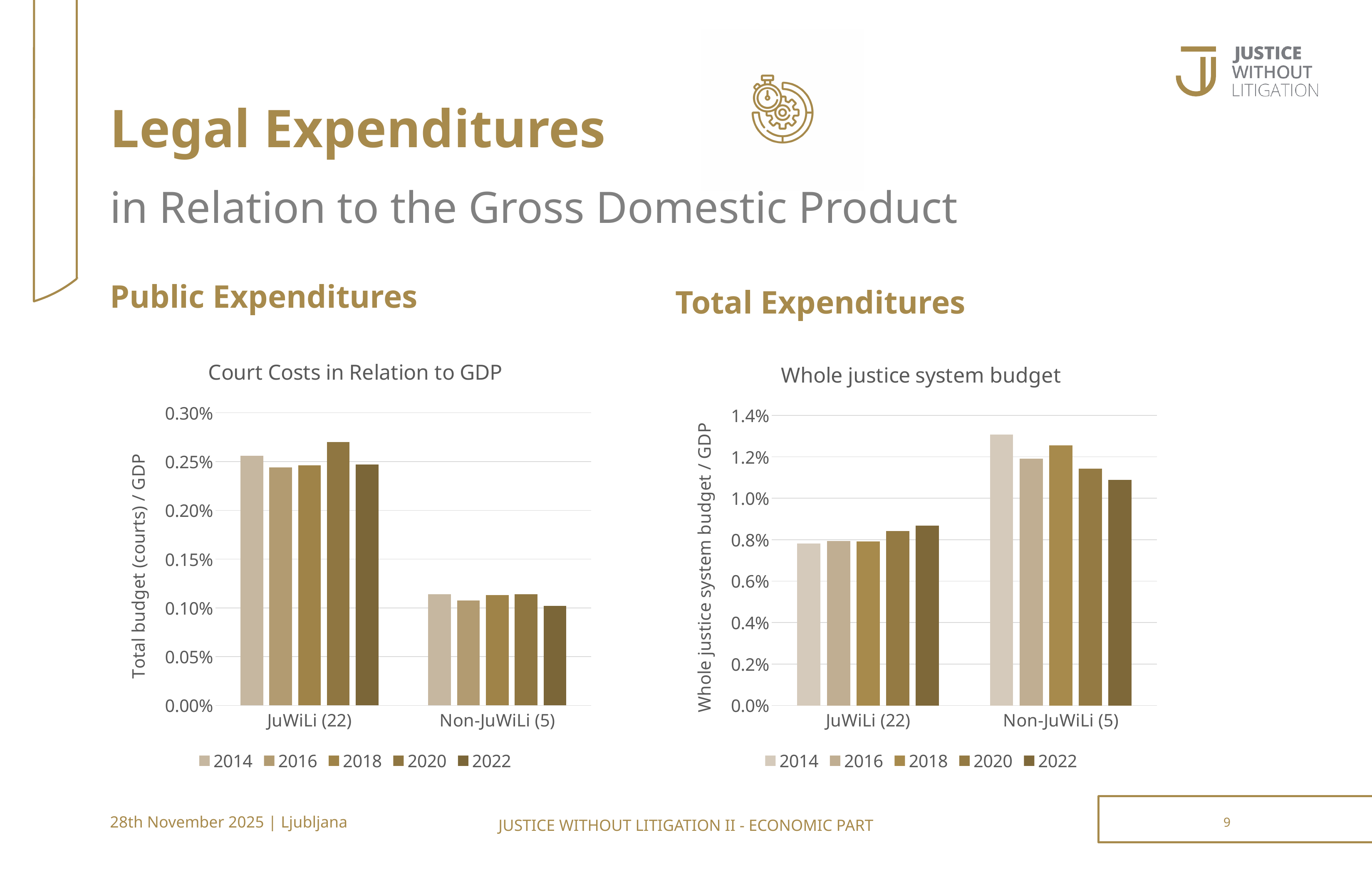
In the 'Court Costs in Relation to GDP' chart, what kind of chart is shown? bar chart In the 'Court Costs in Relation to GDP' chart, how many series does the legend list? 5 In the 'Whole justice system budget' chart, what is the label of the vertical axis? Whole justice system budget / GDP In the 'Whole justice system budget' chart, is the 2022 value for JuWiLi (22) greater or less than 1.0%? less In the 'Whole justice system budget' chart, which year has the highest value for Non-JuWiLi (5)? 2014 In the 'Court Costs in Relation to GDP' chart, which year has the highest value for JuWiLi (22)? 2020 In the 'Whole justice system budget' chart, is the 2014 value for Non-JuWiLi (5) greater or less than 1.2%? greater In the 'Court Costs in Relation to GDP' chart, is the 2014 value for Non-JuWiLi (5) greater or less than 0.10%? greater In the 'Court Costs in Relation to GDP' chart, which category has the larger 2018 value, JuWiLi (22) or Non-JuWiLi (5)? JuWiLi (22) In the 'Court Costs in Relation to GDP' chart, which year has the lowest value for Non-JuWiLi (5)? 2022 In the 'Whole justice system budget' chart, how many categories are shown on the x axis? 2